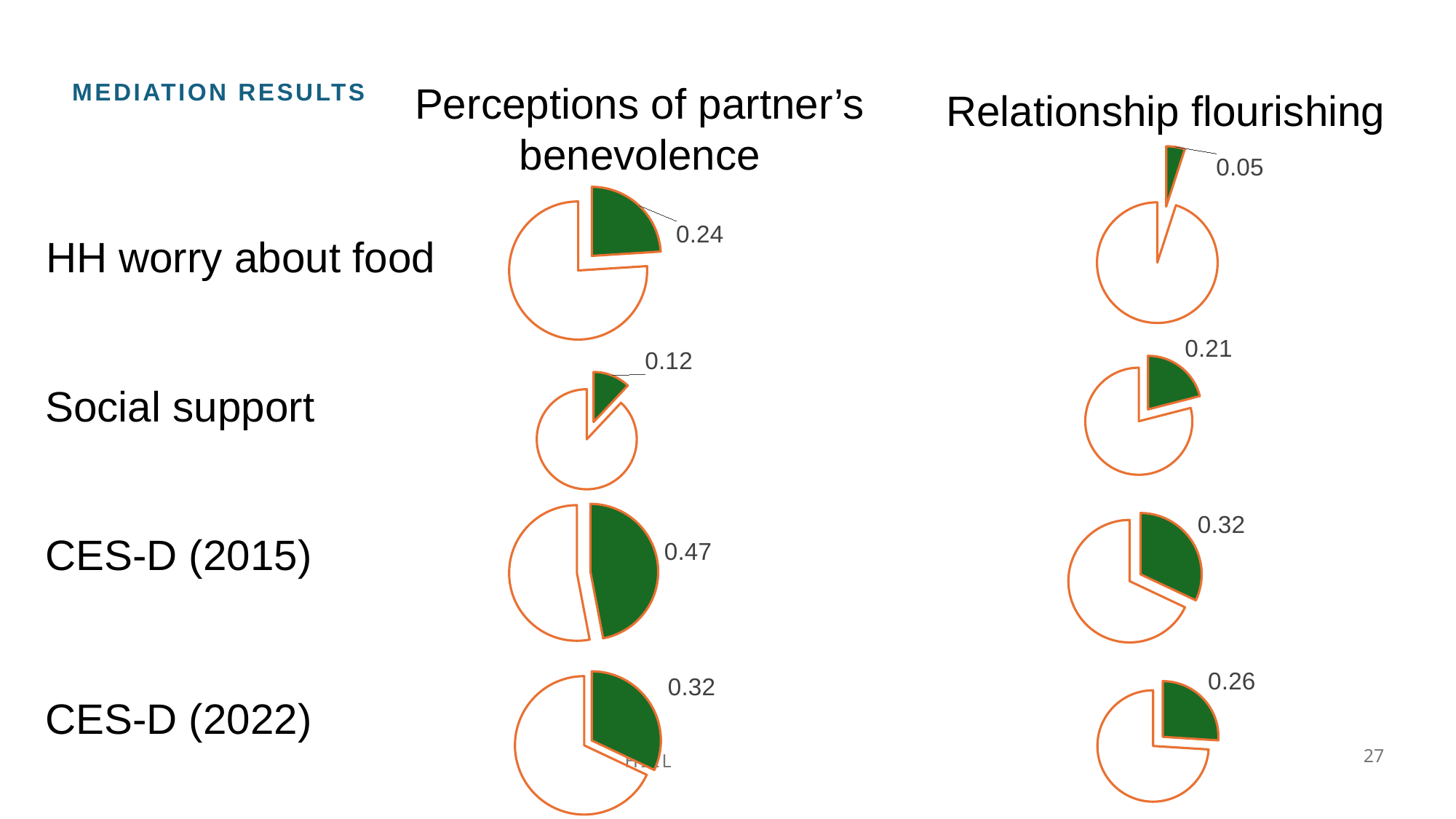
What colour is the highlighted slice in each pie chart? Green What kind of chart is used for each of the mediation results on this slide? Pie chart In the 'Relationship flourishing' column, what value is labelled on the pie chart for CES-D (2022)? 0.26 For Social support, which column shows the larger labelled value: 'Perceptions of partner's benevolence' or 'Relationship flourishing'? Relationship flourishing What is the difference between the labelled values for CES-D (2015) and CES-D (2022) in the 'Perceptions of partner's benevolence' column? 0.15 In the 'Relationship flourishing' column, what value is labelled on the pie chart for HH worry about food? 0.05 How many pie charts are shown on the slide in total? 8 In the 'Relationship flourishing' column, what value is labelled on the pie chart for CES-D (2015)? 0.32 In the 'Perceptions of partner's benevolence' column, what value is labelled on the pie chart for Social support? 0.12 In the 'Perceptions of partner's benevolence' column, what value is labelled on the pie chart for HH worry about food? 0.24 Among the four pie charts in the 'Perceptions of partner's benevolence' column, which row has the largest labelled value? CES-D (2015) Among the four pie charts in the 'Relationship flourishing' column, which row has the smallest labelled value? HH worry about food